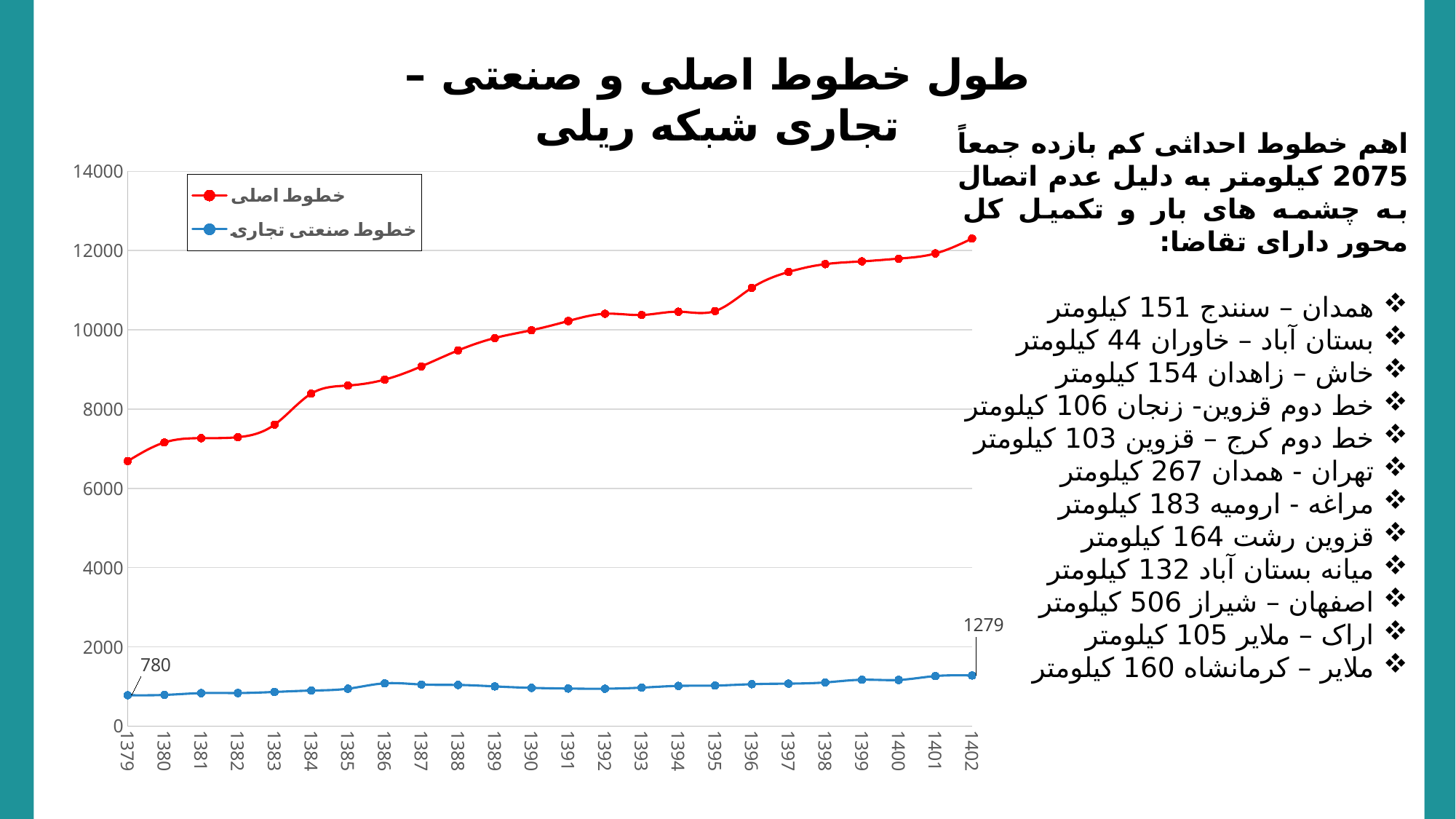
How many years are plotted along the x axis of the chart? 24 Is the value for خطوط اصلی in 1396 greater or less than 10000? greater What is the value of خطوط صنعتی تجاری in 1379? 780 What colour is the line for خطوط اصلی in the chart? red Is the value for خطوط اصلی in 1379 greater or less than 8000? less By how much did خطوط صنعتی تجاری increase from 1379 to 1402? 499 What kind of chart is shown on the slide? line chart Is the value for خطوط اصلی in 1402 greater or less than 12000? greater What is the value of خطوط صنعتی تجاری in 1402? 1279 Does the خطوط اصلی series rise or fall from 1379 to 1402? rise Which series has the higher value in 1402, خطوط اصلی or خطوط صنعتی تجاری? خطوط اصلی How many series does the chart legend list? 2